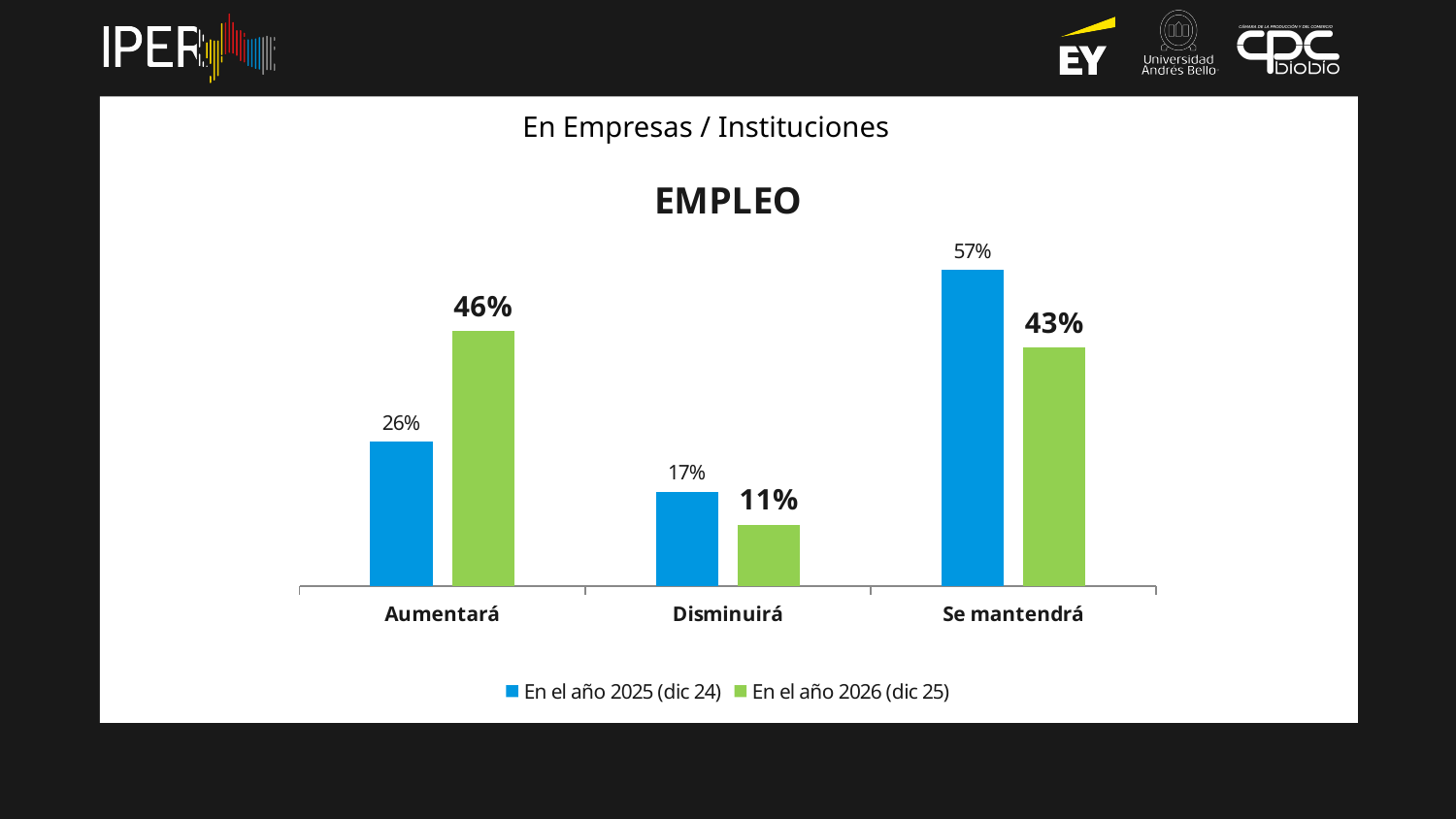
Which category has the lowest value in the series En el año 2026 (dic 25)? Disminuirá How many series does the legend list? 2 Which category has the highest value in the series En el año 2025 (dic 24)? Se mantendrá What is the difference between the En el año 2026 (dic 25) and En el año 2025 (dic 24) values for Aumentará? 20% What is the value for Aumentará in the series En el año 2026 (dic 25)? 46% What is the difference between the En el año 2025 (dic 24) and En el año 2026 (dic 25) values for Se mantendrá? 14% What kind of chart is shown on the slide? Bar chart How many categories are shown on the x axis? 3 What is the value for Disminuirá in the series En el año 2026 (dic 25)? 11% Which is larger for Disminuirá: the En el año 2025 (dic 24) value or the En el año 2026 (dic 25) value? En el año 2025 (dic 24) What is the title of the chart? EMPLEO What is the value for Se mantendrá in the series En el año 2025 (dic 24)? 57%